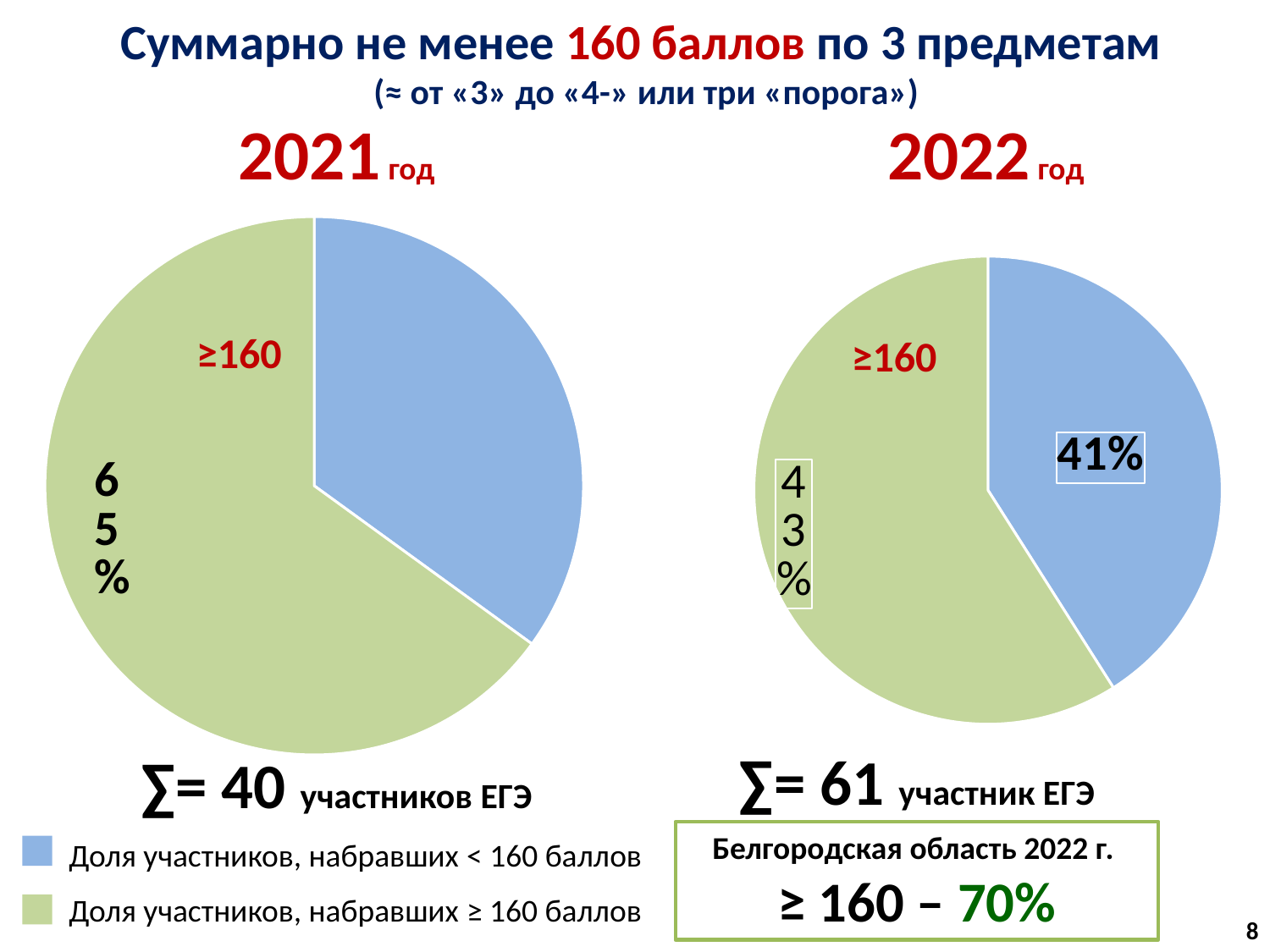
How many ЕГЭ participants are represented in the 2022 год pie chart (∑)? 61 How many slices does the 2021 год pie chart have? 2 Which colour represents the share of participants who scored < 160 points? blue What kind of chart is used for the 2021 год data? pie chart How many entries does the legend list? 2 In the 2022 год pie chart, what value is printed on the green slice (participants scoring ≥ 160 points)? 43% In the 2022 год pie chart, which slice is larger: the green (≥ 160) or the blue (< 160)? green (≥ 160) In the 2021 год pie chart, which slice is larger: participants with ≥ 160 points or participants with < 160 points? ≥ 160 points What share of participants scoring ≥ 160 is given for Белгородская область in 2022? 70% In the 2022 год pie chart, what value is shown for the blue slice (participants scoring < 160 points)? 41% How many ЕГЭ participants are represented in the 2021 год pie chart (∑)? 40 In the 2021 год pie chart, what share of participants scored ≥160 points? 65%